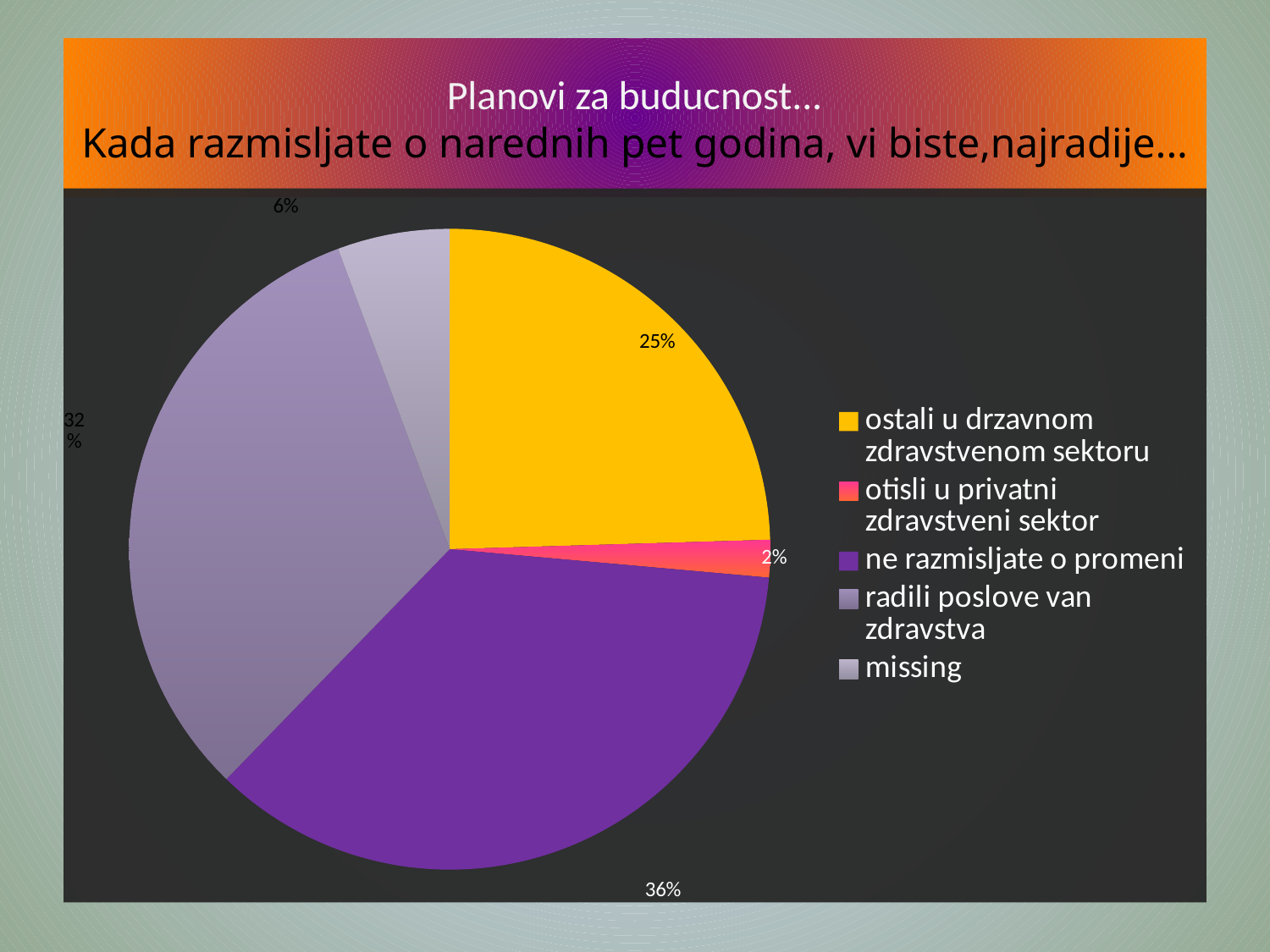
How many categories does the legend list? 5 What colour is the slice for 'ostali u drzavnom zdravstvenom sektoru'? yellow What is the difference in percentage points between 'ne razmisljate o promeni' and 'ostali u drzavnom zdravstvenom sektoru'? 11 What kind of chart is shown on the slide? pie chart What share of the pie is labelled 'ostali u drzavnom zdravstvenom sektoru'? 25% What share of the pie is labelled 'missing'? 6% What share of the pie is labelled 'radili poslove van zdravstva'? 32% Which is larger: the slice for 'radili poslove van zdravstva' or the slice for 'ostali u drzavnom zdravstvenom sektoru'? radili poslove van zdravstva Which category has the largest slice of the pie? ne razmisljate o promeni Which category has the smallest slice of the pie? otisli u privatni zdravstveni sektor